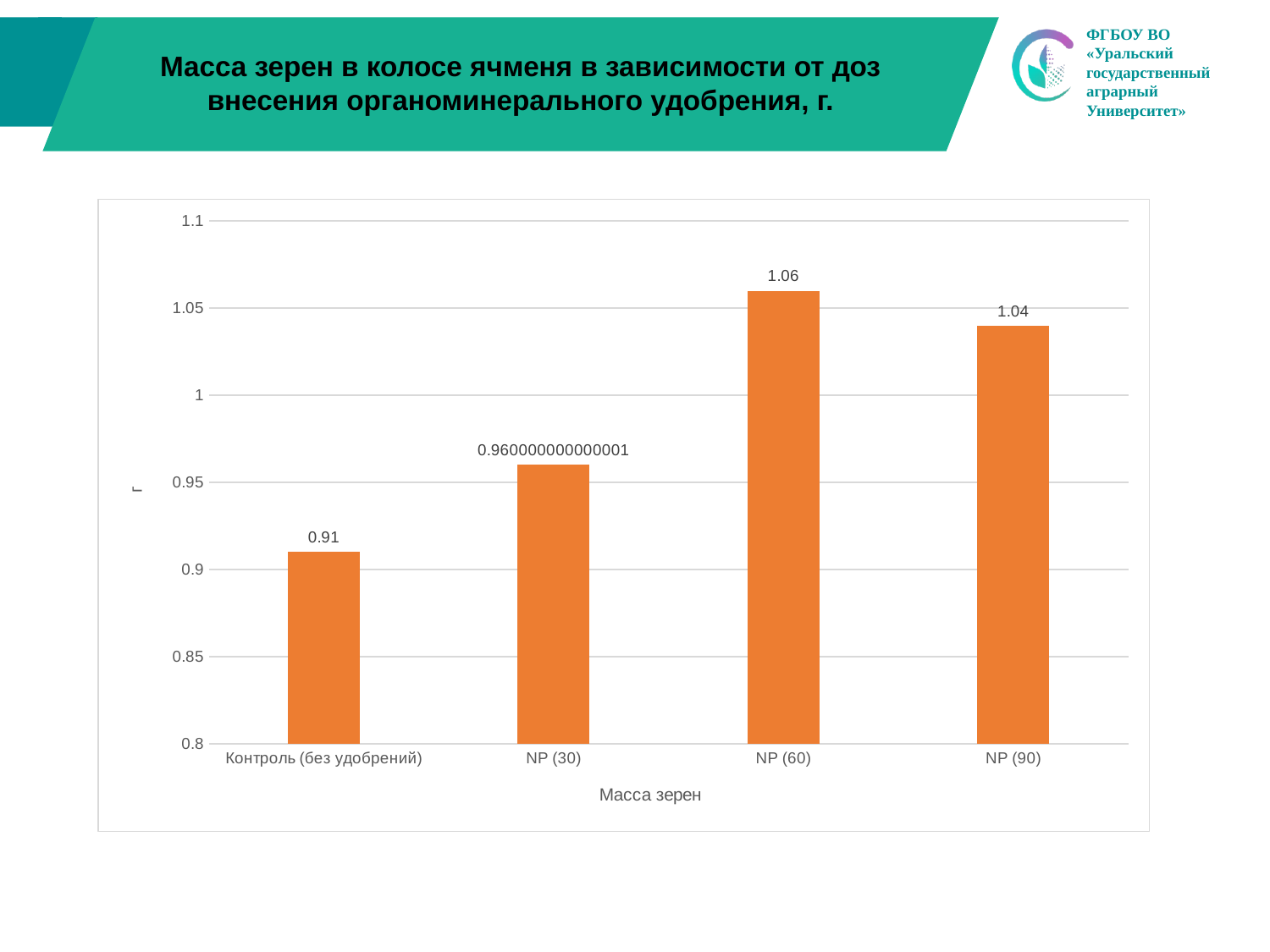
What is the data label shown for NP (30)? 0.960000000000001 Is the value for NP (30) greater or less than 1? less How many categories are shown on the x axis? 4 What is the value for NP (90)? 1.04 Which is larger, the value for NP (90) or the value for NP (30)? NP (90) Which category has the highest value? NP (60) What kind of chart is shown on the slide? bar chart What is the difference between the values for NP (60) and Контроль (без удобрений)? 0.15 What is the value for Контроль (без удобрений)? 0.91 What is the difference between the values for NP (60) and NP (90)? 0.02 What is the value for NP (60)? 1.06 Which category has the lowest value? Контроль (без удобрений)